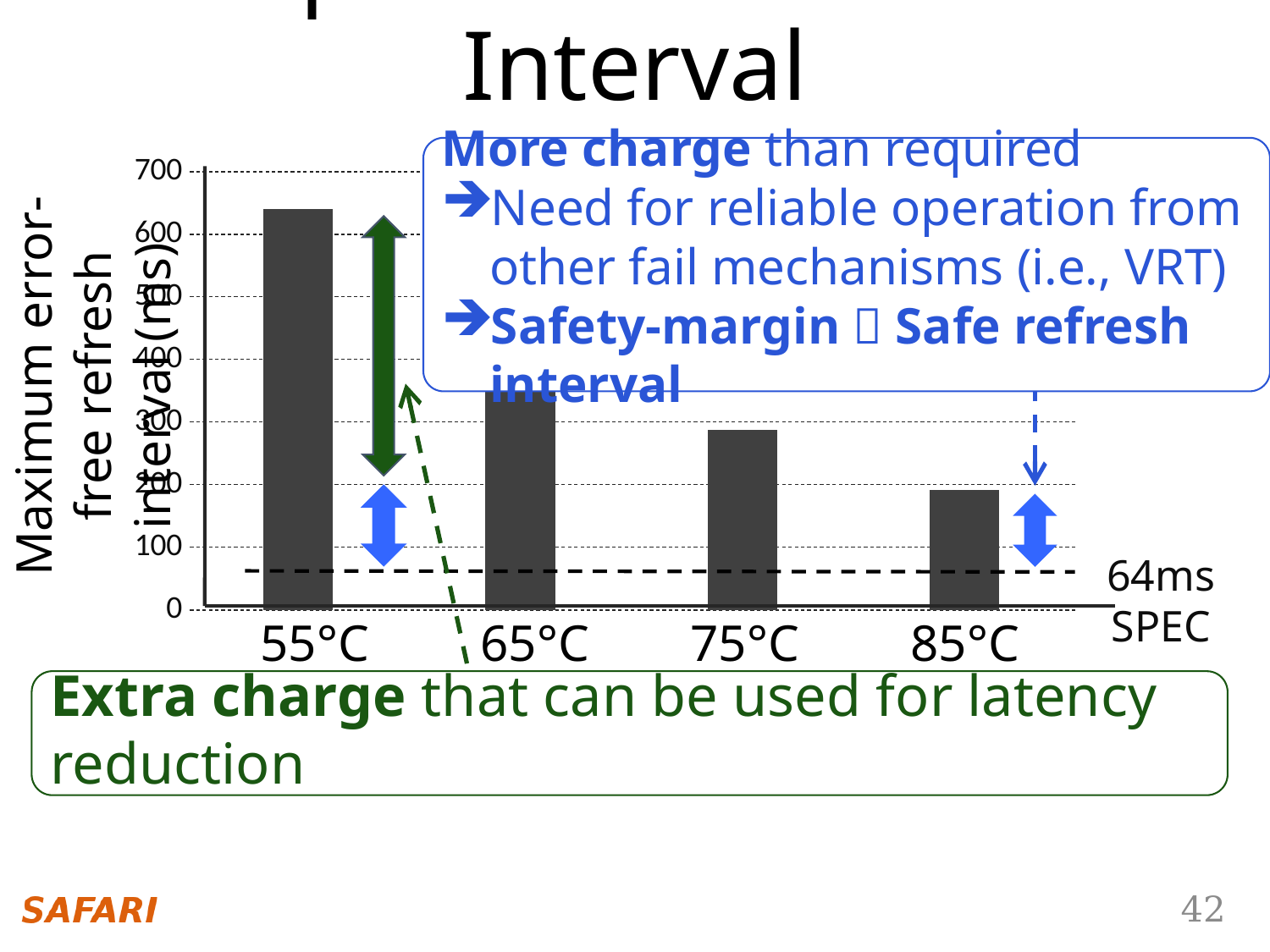
Is the value for 85°C greater or less than 100? greater Is the value for 55°C greater or less than 600? greater What is the label of the y axis? Maximum error-free refresh interval (ms) Is the value for 75°C greater or less than 400? less Do the bar values rise or fall as temperature increases along the x axis? fall How many temperature categories are plotted on the x axis? 4 What does the horizontal dashed line on the chart represent? 64ms SPEC Which temperature has the highest maximum error-free refresh interval? 55°C What kind of chart is shown on the slide? bar chart Which is larger, the value for 55°C or the value for 85°C? 55°C Which temperature has the lowest maximum error-free refresh interval? 85°C